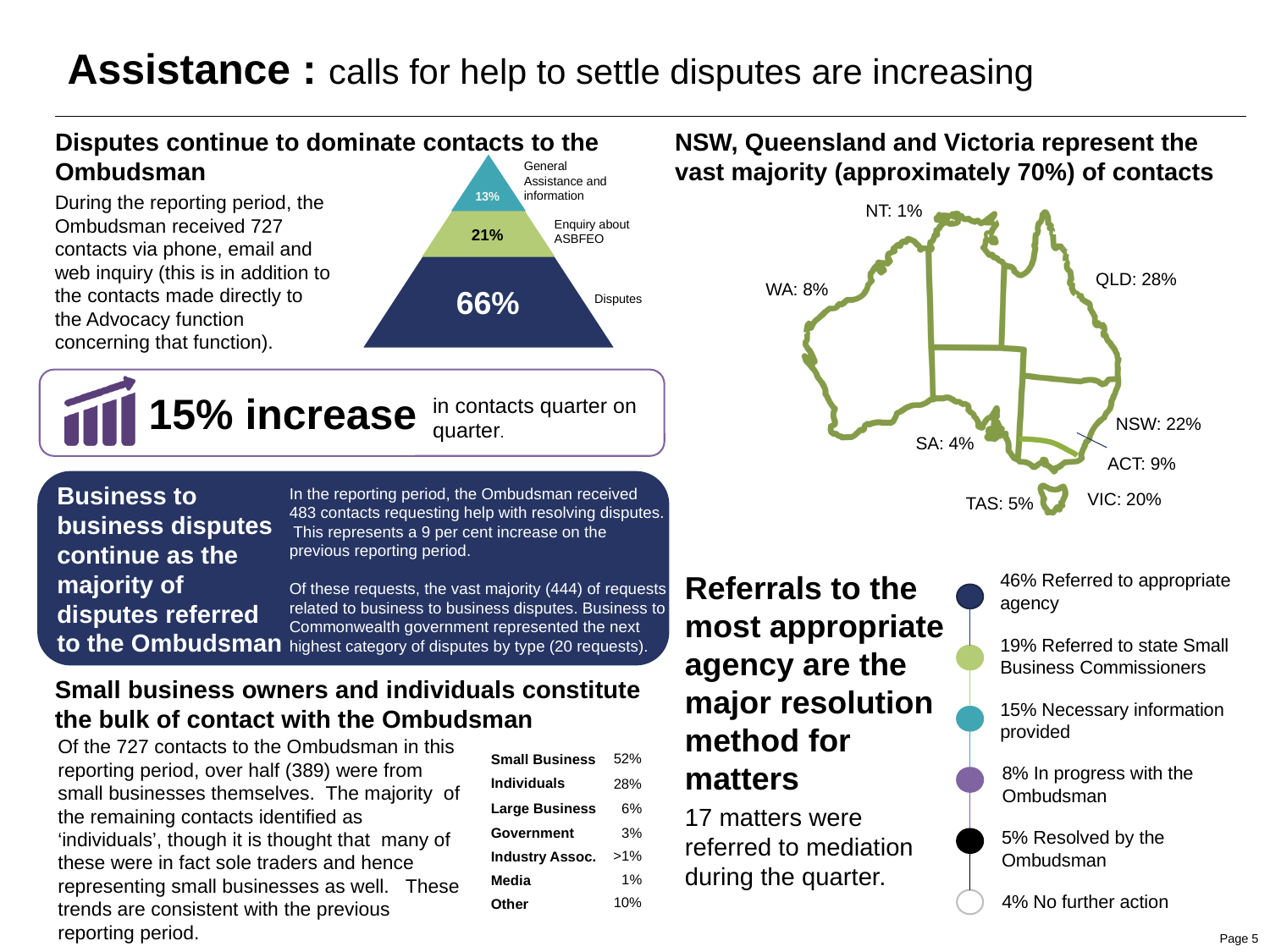
In the map chart under 'NSW, Queensland and Victoria represent the vast majority (approximately 70%) of contacts', which is larger, NSW or VIC? NSW What kind of chart is shown under 'Disputes continue to dominate contacts to the Ombudsman'? Pyramid chart In the map chart under 'NSW, Queensland and Victoria represent the vast majority (approximately 70%) of contacts', what is the difference in percentage points between QLD and WA? 20 In the pyramid chart under 'Disputes continue to dominate contacts to the Ombudsman', which category has the smallest share? General Assistance and information In the pyramid chart under 'Disputes continue to dominate contacts to the Ombudsman', which category has the largest share? Disputes In the pyramid chart under 'Disputes continue to dominate contacts to the Ombudsman', what percentage is shown for Enquiry about ASBFEO? 21% In the pyramid chart under 'Disputes continue to dominate contacts to the Ombudsman', what percentage is shown for Disputes? 66% In the map chart under 'NSW, Queensland and Victoria represent the vast majority (approximately 70%) of contacts', what percentage is shown for QLD? 28% In the map chart under 'NSW, Queensland and Victoria represent the vast majority (approximately 70%) of contacts', which state or territory has the lowest percentage? NT In the pyramid chart under 'Disputes continue to dominate contacts to the Ombudsman', what is the difference in percentage points between Disputes and Enquiry about ASBFEO? 45 How many segments does the pyramid chart under 'Disputes continue to dominate contacts to the Ombudsman' have? 3 In the pyramid chart under 'Disputes continue to dominate contacts to the Ombudsman', what percentage is shown for General Assistance and information? 13%